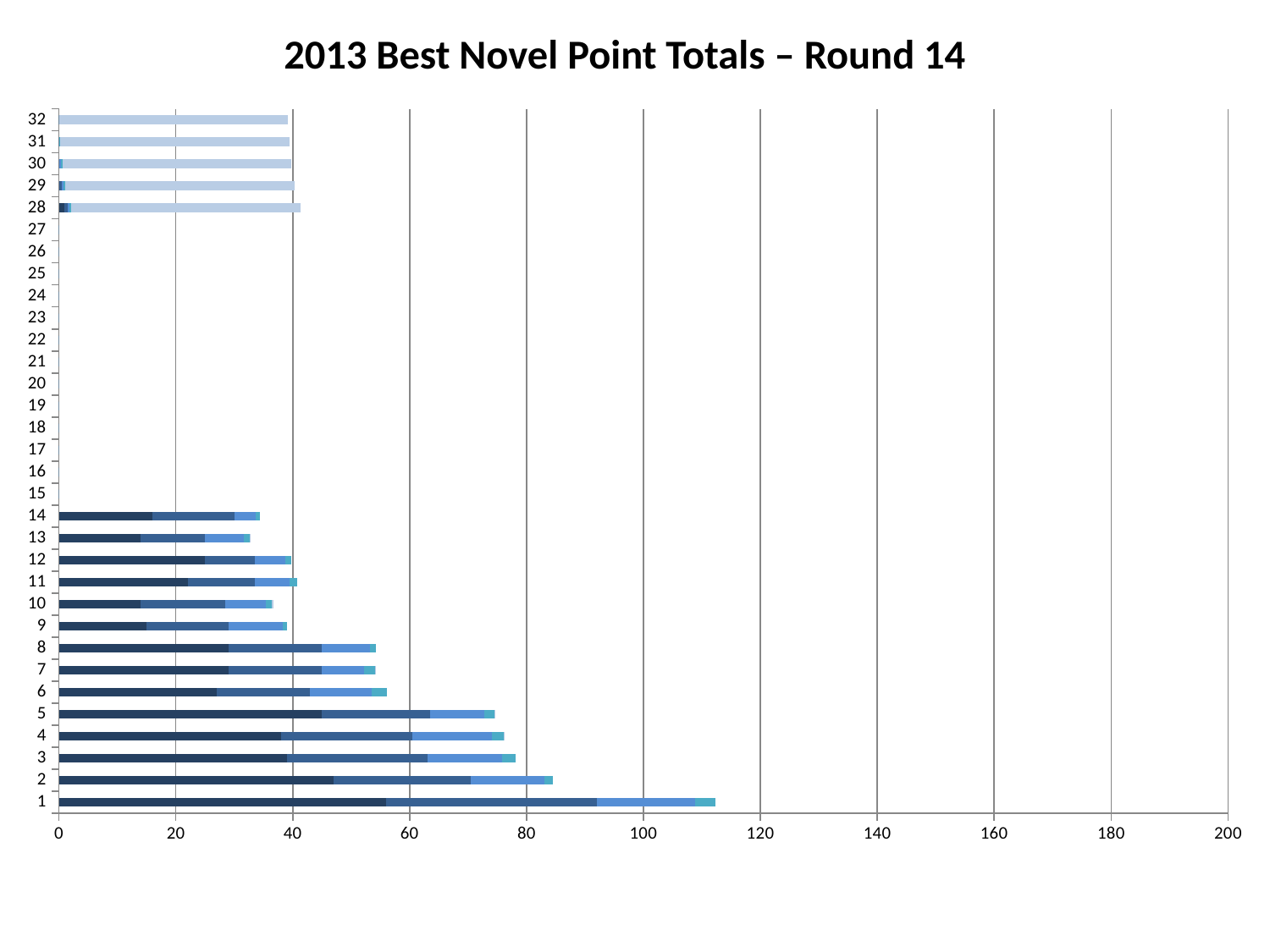
Is the total value for category 1 greater or less than 100? greater Which category has the longest bar in the chart? 1 Which has the longer bar, category 3 or category 14? 3 Which has the longer bar, category 6 or category 9? 6 What kind of chart is shown on the slide? bar chart How many categories are listed on the vertical axis of the chart? 32 Is the total value for category 5 greater or less than 60? greater Do the bar lengths generally rise or fall going from category 1 up to category 14? fall What is the title of the chart? 2013 Best Novel Point Totals – Round 14 Is the total value for category 14 greater or less than 40? less